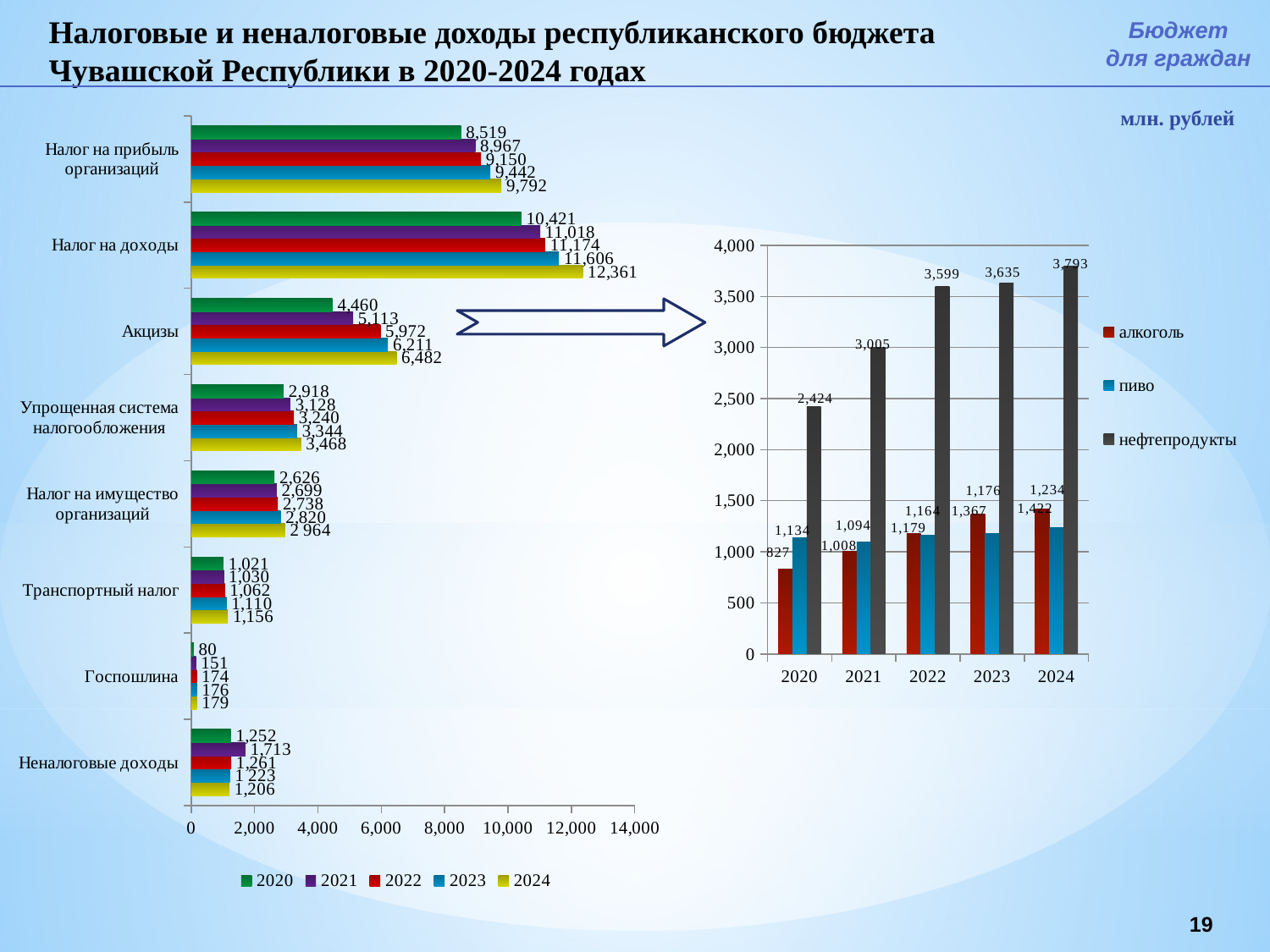
In the left chart, which category has the lowest value in 2020? Госпошлина What kind of chart is the right chart? bar chart In the left chart, what is the value for Налог на доходы in 2024? 12,361 In the right chart, what is the difference between пиво in 2024 and пиво in 2020? 100 In the left chart, do the values for Транспортный налог rise or fall from 2020 to 2024? rise In the right chart, what is the value for алкоголь in 2020? 827 In the right chart, which year has the highest value for нефтепродукты? 2024 In the left chart, what is the value for Акцизы in 2020? 4,460 In the left chart, which is larger for Неналоговые доходы: the 2021 value or the 2024 value? 2021 In the left chart, how many series does the legend list? 5 In the right chart, what is the value for нефтепродукты in 2022? 3,599 In the left chart, what is the difference between the 2024 and 2020 values for Налог на прибыль организаций? 1,273